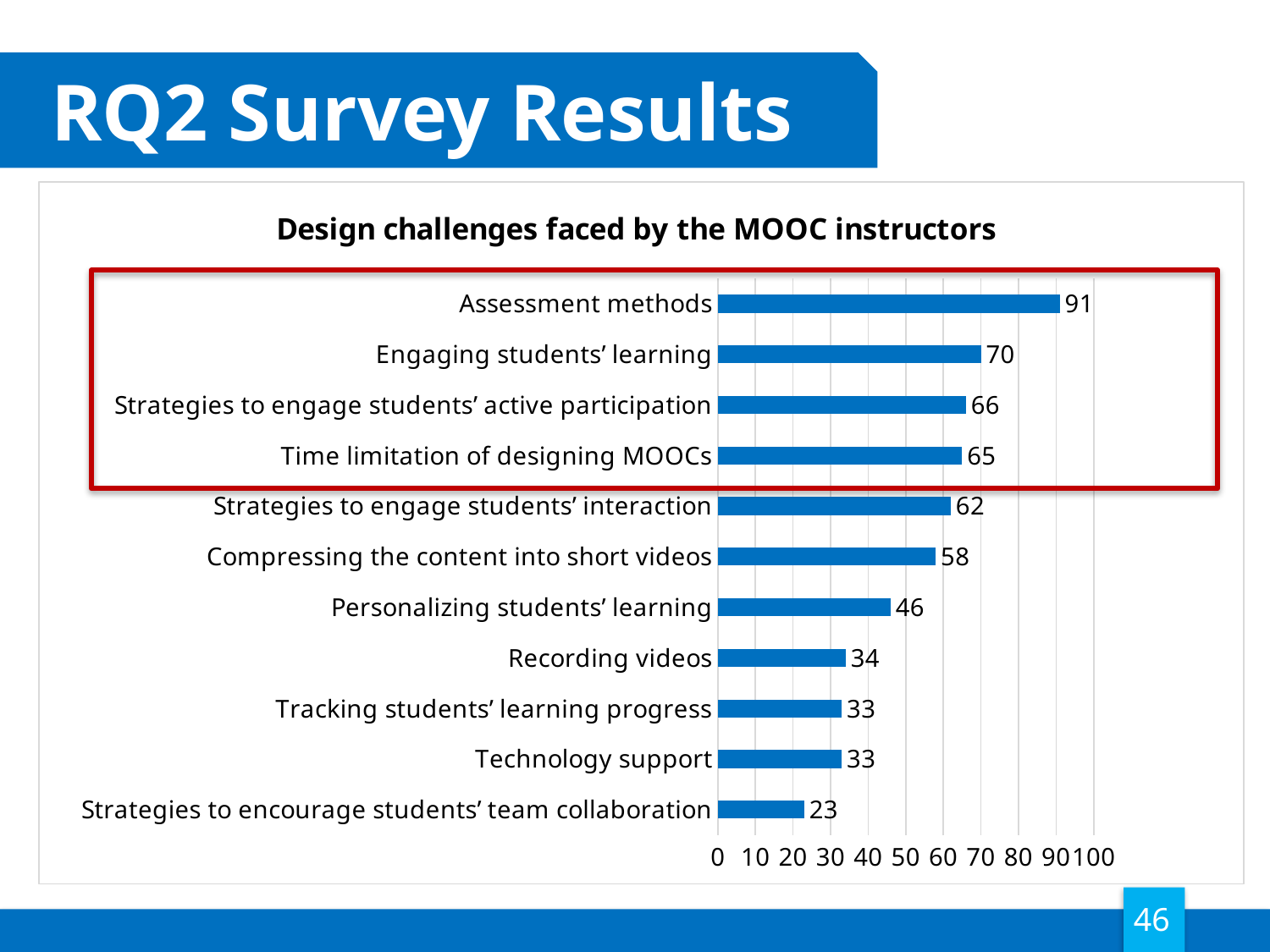
What is the title of the chart? Design challenges faced by the MOOC instructors How many design challenges are shown in the chart? 11 What is the value for Assessment methods? 91 What is the value for Time limitation of designing MOOCs? 65 What is the value for Recording videos? 34 What kind of chart is shown on the slide? Bar chart What is the difference between the values for Assessment methods and Engaging students' learning? 21 Which design challenge has the highest value? Assessment methods Which is larger, the value for Compressing the content into short videos or the value for Personalizing students' learning? Compressing the content into short videos Which design challenge has the lowest value? Strategies to encourage students' team collaboration How many categories are enclosed by the red box on the chart? 4 Is the value for Strategies to engage students' interaction greater or less than 50? greater